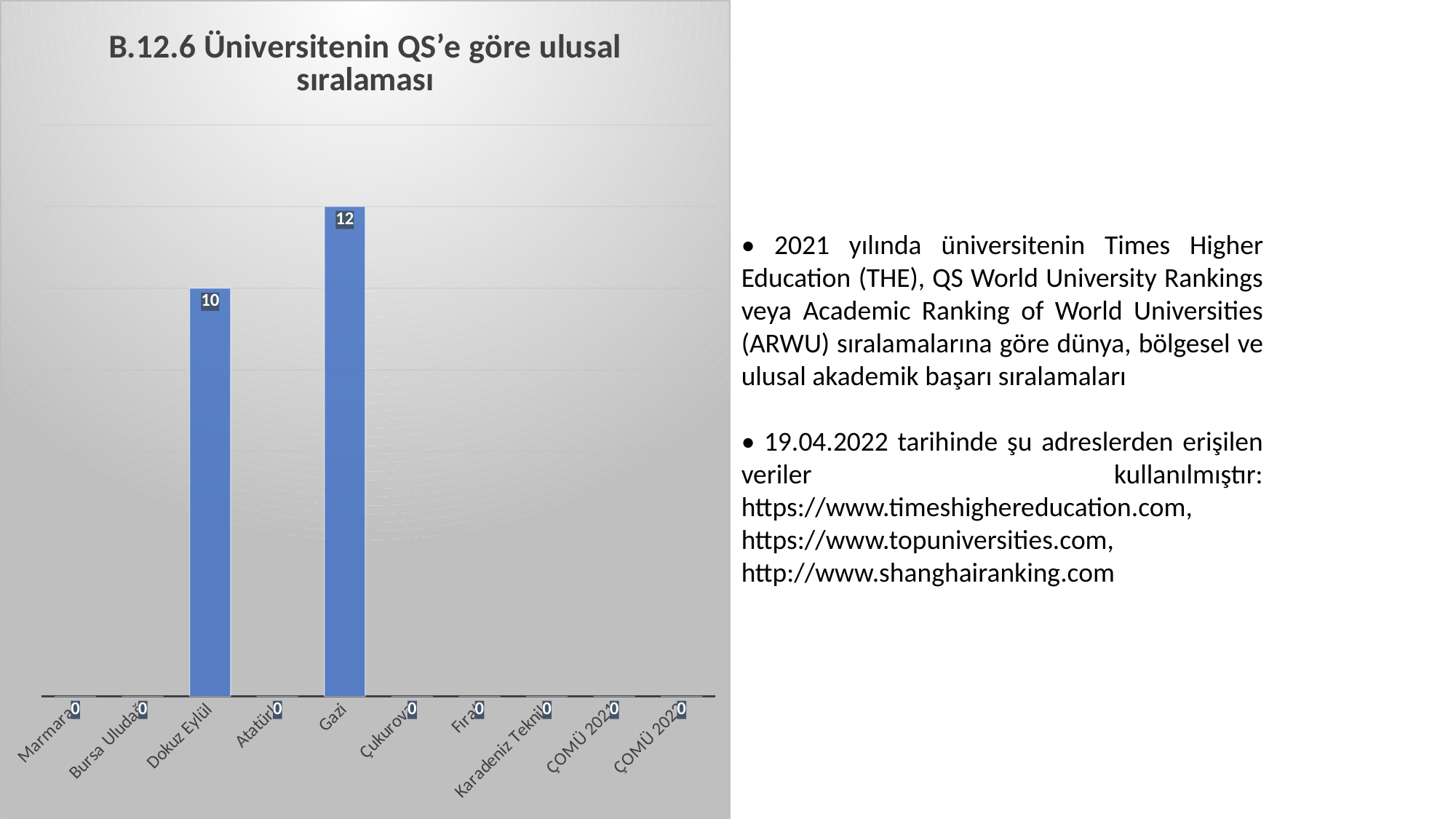
What is the value shown for ÇOMÜ 2021? 0 Which category has the highest value? Gazi How many categories have a value greater than 0? 2 What is the value shown for Gazi? 12 What is the value shown for Karadeniz Teknik? 0 What kind of chart is shown on the slide? Bar chart What is the difference between the values for Gazi and Dokuz Eylül? 2 How many categories are shown on the x axis? 10 Which is larger, the value for Gazi or the value for Dokuz Eylül? Gazi What is the value shown for Marmara? 0 What is the title of the chart? B.12.6 Üniversitenin QS'e göre ulusal sıralaması What is the value shown for Dokuz Eylül? 10